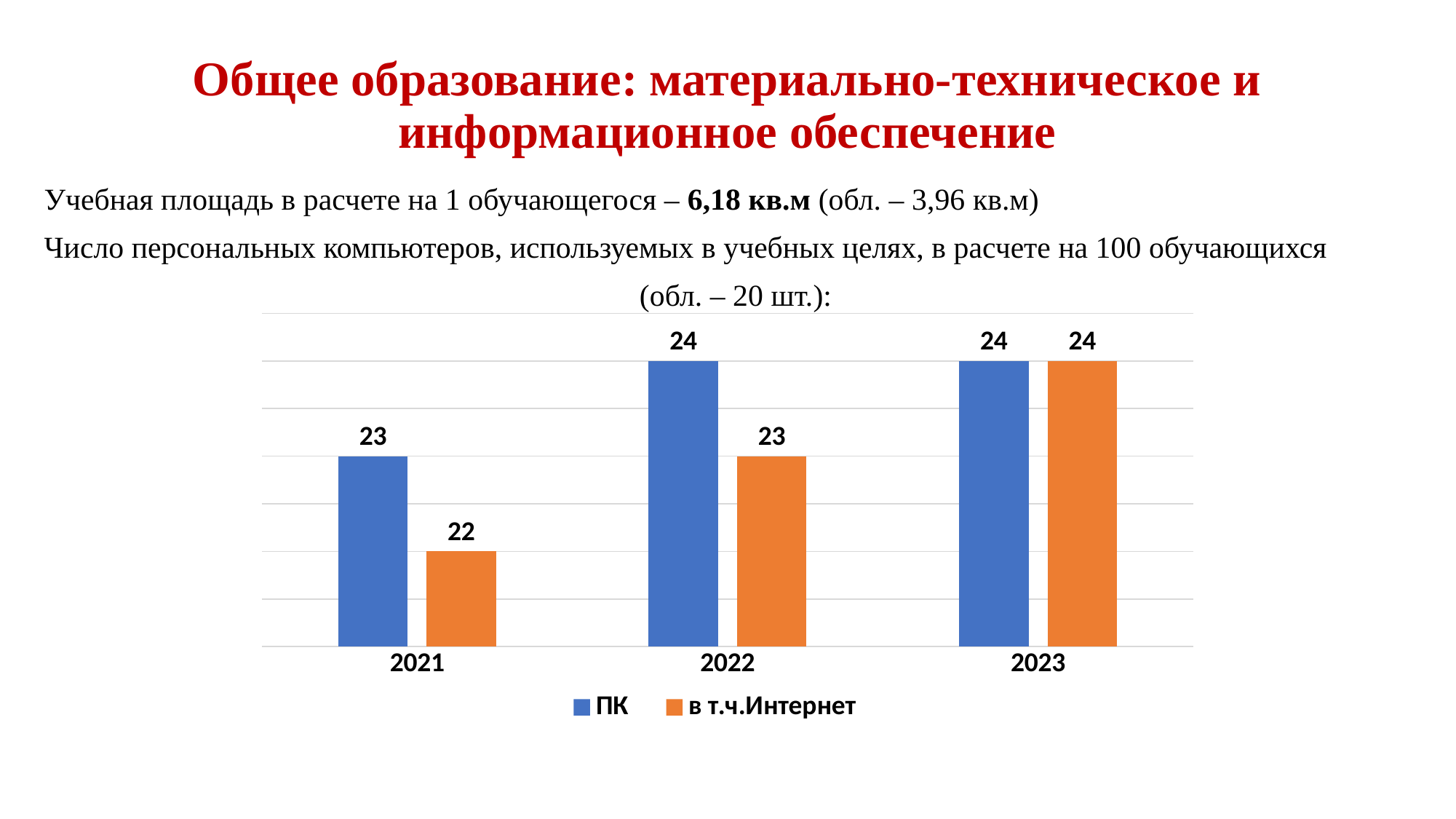
In which year is the value for в т.ч.Интернет the lowest? 2021 What kind of chart is shown on the slide? bar chart What is the value for ПК in 2022? 24 How many years are shown on the x axis of the chart? 3 Which is larger in 2021: the value for ПК or the value for в т.ч.Интернет? ПК Does the value for в т.ч.Интернет rise or fall from 2021 to 2023? rise What is the difference between the ПК value and the в т.ч.Интернет value in 2022? 1 What is the value for в т.ч.Интернет in 2021? 22 What is the value for в т.ч.Интернет in 2022? 23 What is the value for ПК in 2021? 23 What is the value for в т.ч.Интернет in 2023? 24 How many series does the chart legend list? 2